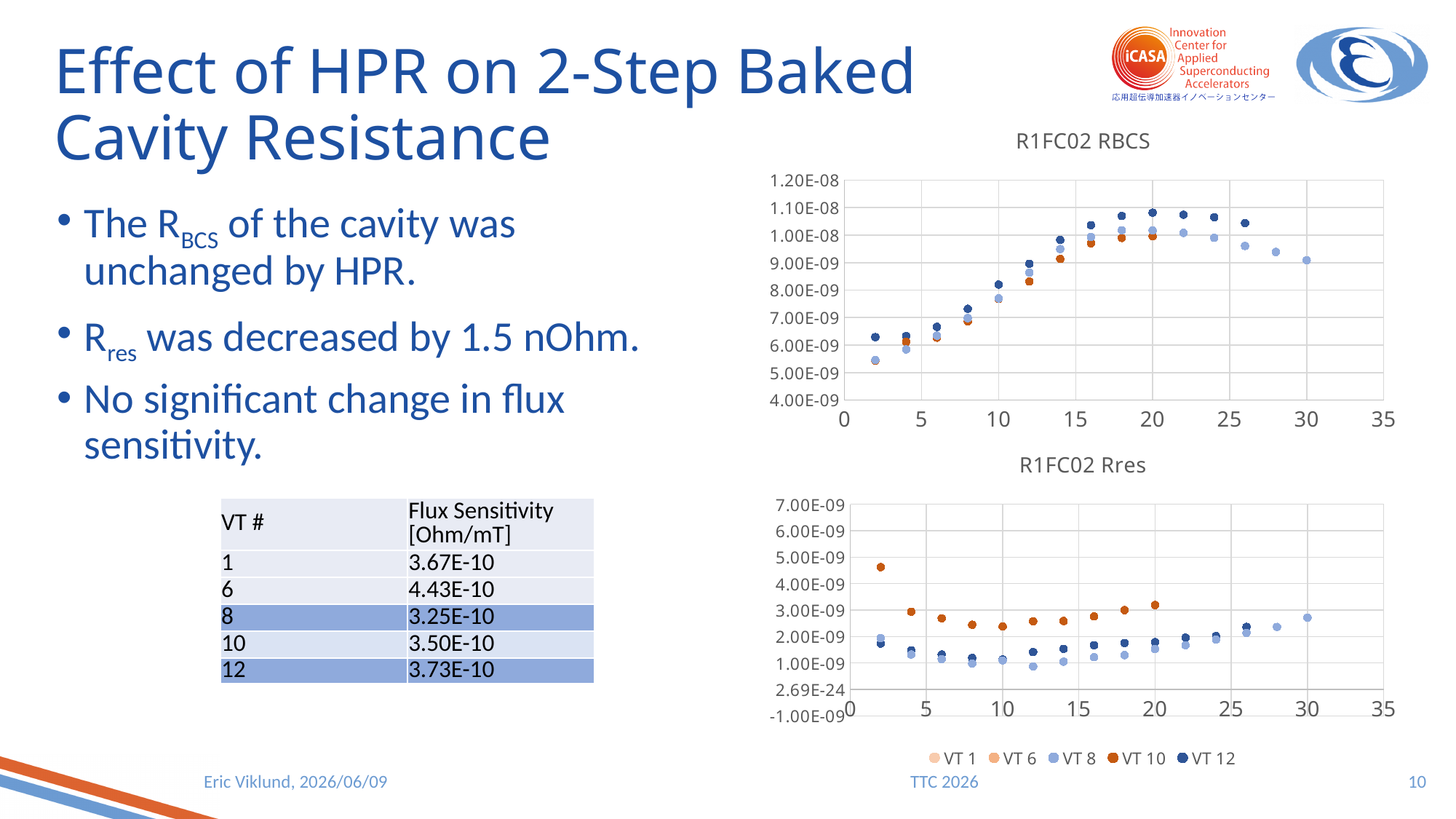
In the R1FC02 Rres chart, is the VT 10 value at x = 2 greater or less than 4.00E-09? greater What is the title of the upper chart on the slide? R1FC02 RBCS Which series are listed in the legend below the R1FC02 Rres chart? VT 1, VT 6, VT 8, VT 10, VT 12 In the R1FC02 RBCS chart, do the values rise or fall as x increases from 2 to 18? rise In the R1FC02 Rres chart at x = 2, which series has the larger value, VT 10 or VT 12? VT 10 What kind of chart is the R1FC02 RBCS chart? scatter chart In the R1FC02 RBCS chart at x = 20, which series has the larger value, VT 12 or VT 10? VT 12 In the R1FC02 RBCS chart, is the VT 12 value at x = 20 greater or less than 1.00E-08? greater What kind of chart is the R1FC02 Rres chart? scatter chart How many series does the legend below the R1FC02 Rres chart list? 5 In the R1FC02 Rres chart, is the VT 12 value at x = 2 greater or less than 2.00E-09? less